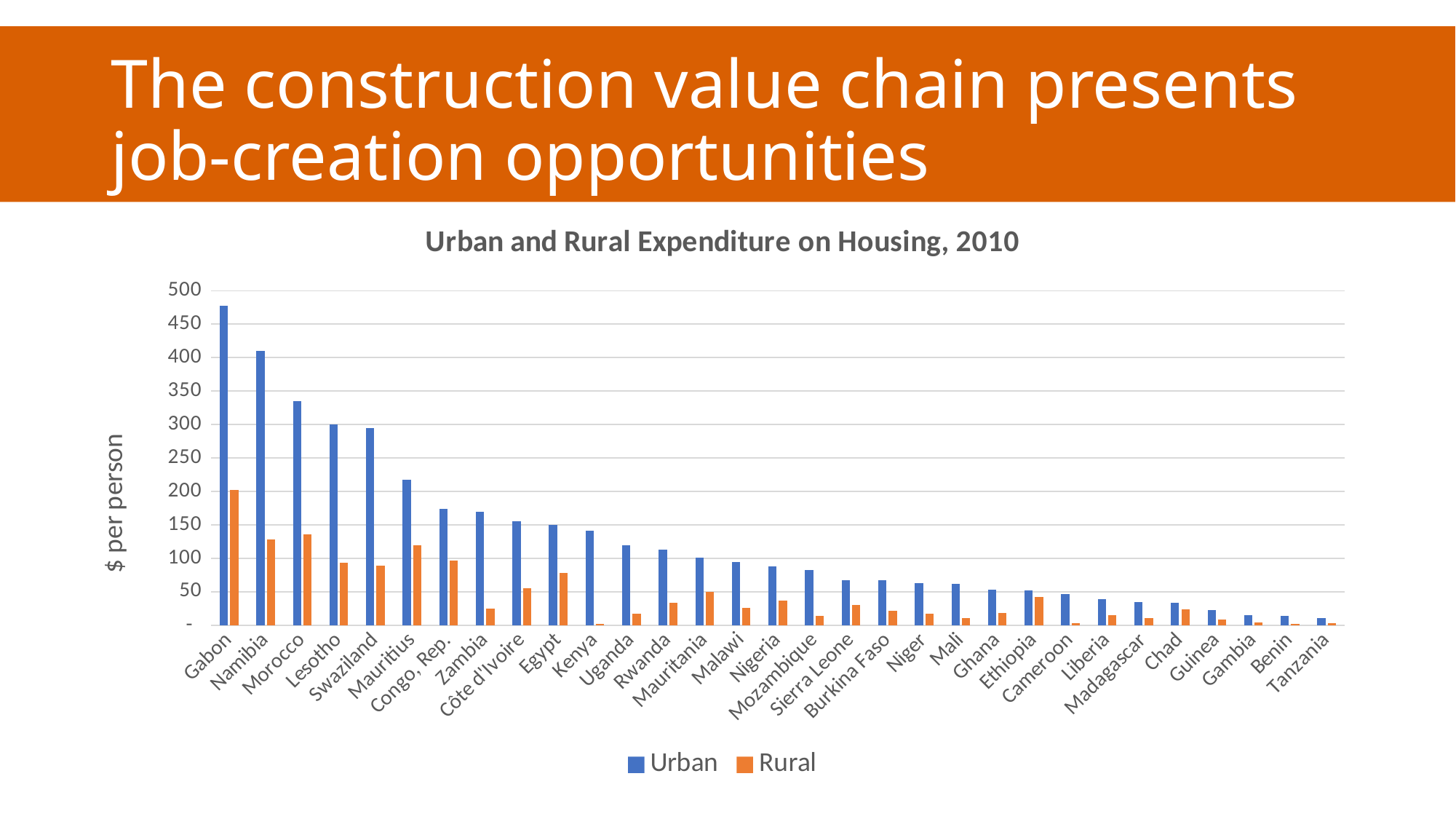
Is the Urban value for Gabon greater or less than 450? greater What is the title of the chart? Urban and Rural Expenditure on Housing, 2010 How many series does the legend list? 2 Is the Urban value for Morocco greater or less than 300? greater Do the Urban values rise or fall moving from left to right along the x axis? Fall How many countries are shown on the x axis of the chart? 31 Which is larger, the Urban value for Namibia or the Urban value for Morocco? Namibia Which country has the highest Urban expenditure on housing? Gabon What kind of chart is shown on the slide? Bar chart Which country has the highest Rural expenditure on housing? Gabon Is the Rural value for Kenya greater or less than 50? less